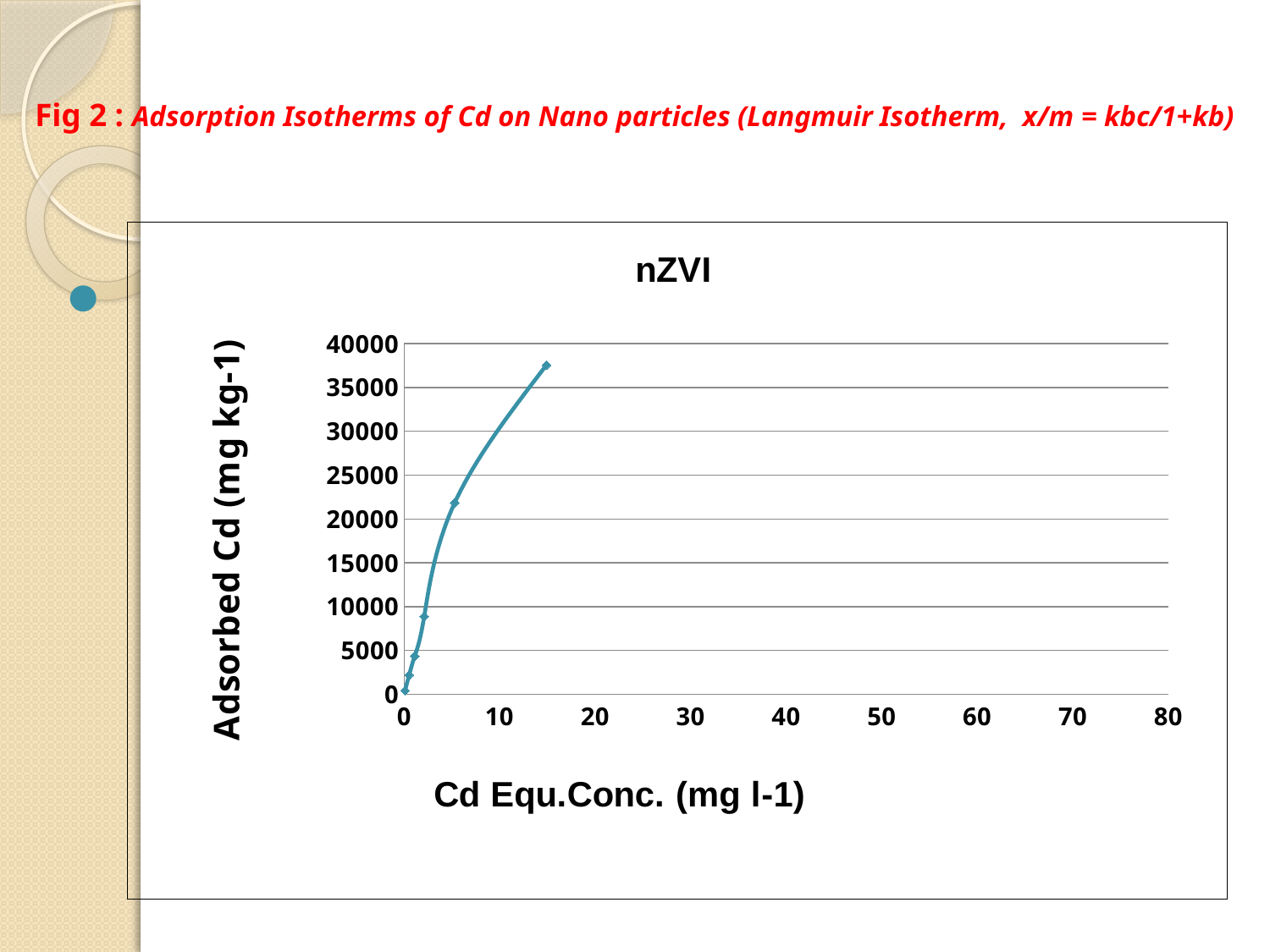
Is the Adsorbed Cd value of the plotted point near 5 on the x axis greater or less than 20000? greater What is the label of the y axis of the chart? Adsorbed Cd (mg kg-1) Is the Cd Equ.Conc. of the rightmost plotted point greater or less than 10? greater Is the Adsorbed Cd value of the highest plotted point greater or less than 35000? greater What is the title of the chart? nZVI Do the plotted values of Adsorbed Cd rise or fall as Cd Equ.Conc. increases along the x axis? rise What type of chart is shown on the slide? line chart What is the highest tick value shown on the x axis of the chart? 80